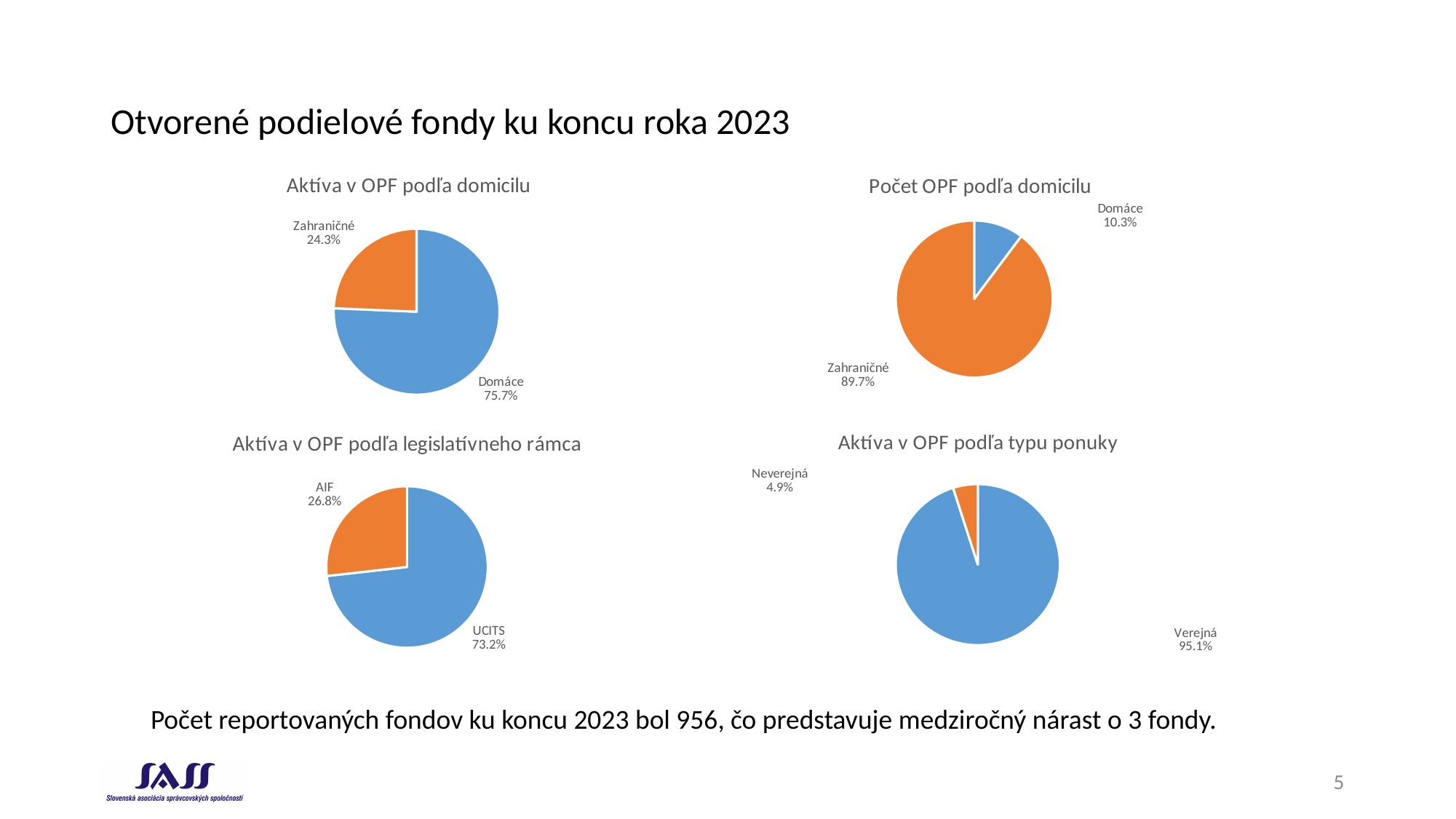
In the chart titled "Aktíva v OPF podľa domicilu", what share does the Domáce slice have? 75.7% In the chart titled "Počet OPF podľa domicilu", which slice is the smallest? Domáce What kind of chart is "Aktíva v OPF podľa legislatívneho rámca"? Pie chart In the chart titled "Aktíva v OPF podľa domicilu", what share does the Zahraničné slice have? 24.3% How many slices does the chart titled "Aktíva v OPF podľa typu ponuky" have? 2 In the chart titled "Aktíva v OPF podľa legislatívneho rámca", what share does the UCITS slice have? 73.2% In the chart titled "Aktíva v OPF podľa typu ponuky", which slice is the largest? Verejná In the chart titled "Aktíva v OPF podľa domicilu", what is the difference in percentage points between the Domáce and Zahraničné slices? 51.4